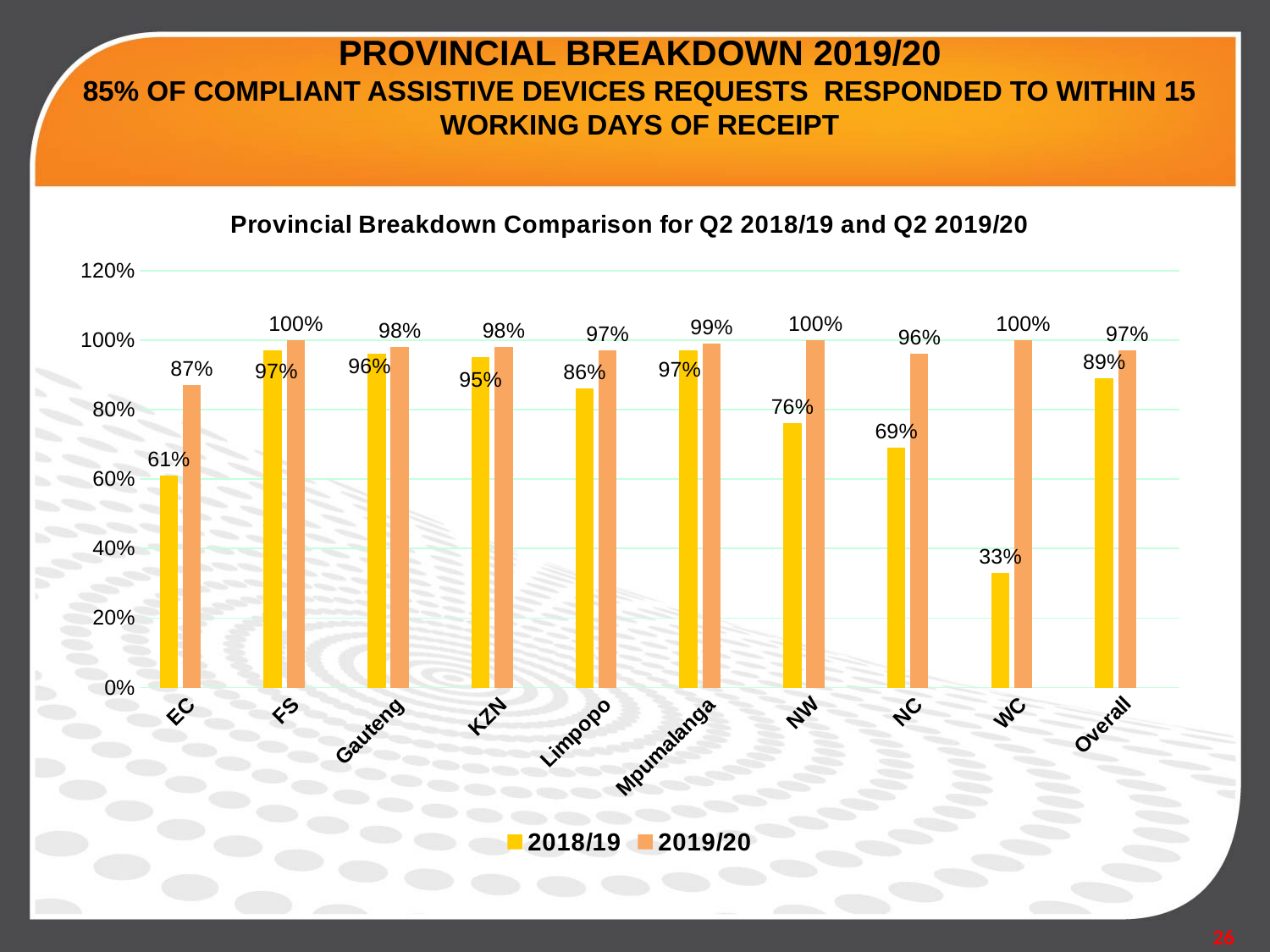
What is the 2018/19 value for NC? 69% How many series does the legend list? 2 Which is larger for NW: the 2018/19 value or the 2019/20 value? 2019/20 What type of chart is shown on the slide? Bar chart What is the difference between the 2019/20 and 2018/19 values for WC? 67 percentage points How many categories are shown on the x axis? 10 What is the 2018/19 value for WC? 33% Which province has the lowest 2018/19 value? WC What is the 2019/20 value for EC? 87% What is the Overall value for 2019/20? 97% What is the difference between the 2019/20 and 2018/19 values for EC? 26 percentage points Which category has the lowest 2019/20 value? EC